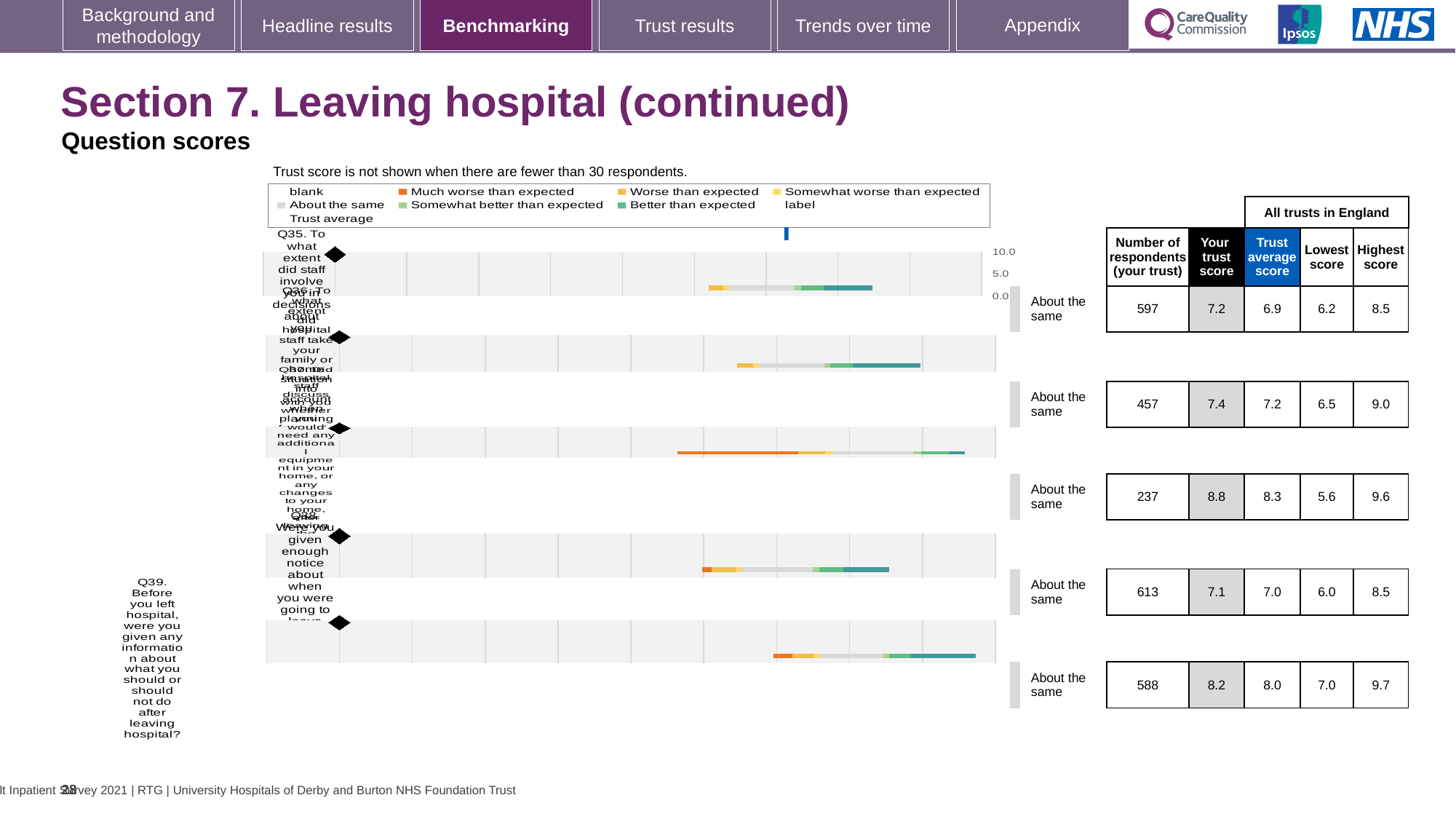
What is the difference between the trust score and the trust average score for the third row (8.8 vs 8.3)? 0.5 What kind of chart is used to show the question scores? Bar chart Which row has the highest 'Your trust score' in the table? The third row (8.8) What is the trust score for the last row (Q39) in the table beside the chart? 8.2 What is the trust average score for the third row (237 respondents) in the table? 8.3 What is the highest score for the last row (Q39) in the table? 9.7 What is the number of respondents for the first row (Q35) in the table beside the chart? 597 How many questions (rows) are plotted in the benchmarking chart? 5 What does the legend entry in orange represent? Much worse than expected Which is larger for the first row: the trust score or the trust average score? Trust score (7.2) Which row has the lowest 'Your trust score' in the table? The fourth row (7.1) What benchmark category is shown for every question in this chart? About the same